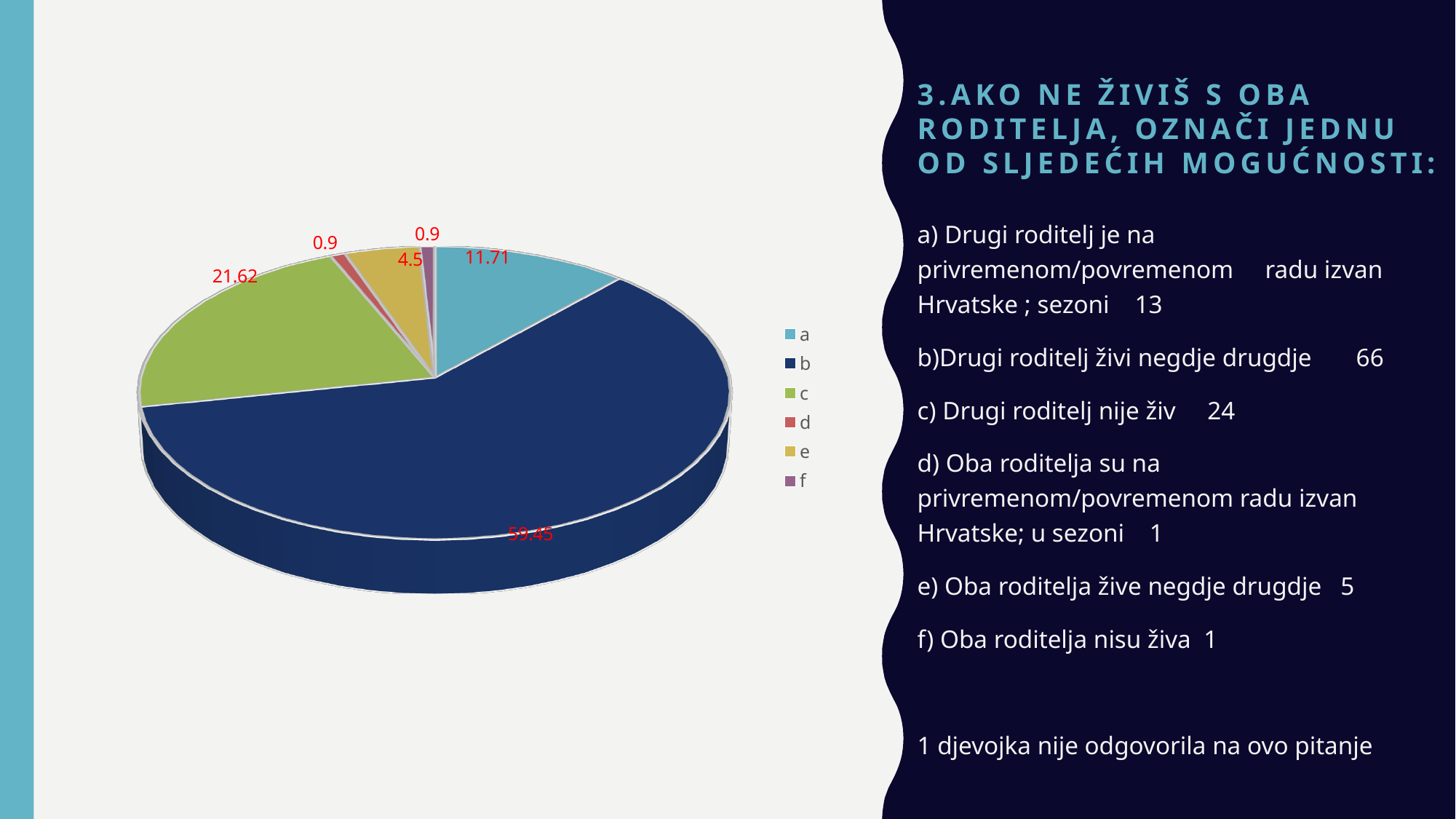
What is the value shown for slice b in the pie chart? 59.45 Which slice of the pie chart is the largest? b What is the difference between the values for slice b and slice c in the pie chart? 37.83 What is the value shown for slice c in the pie chart? 21.62 What colour is slice b in the pie chart? dark blue Which is larger in the pie chart, slice c or slice a? c How many slices does the pie chart have? 6 What is the value shown for slice d in the pie chart? 0.9 What is the difference between the values for slice a and slice e in the pie chart? 7.21 What is the value shown for slice e in the pie chart? 4.5 What is the value shown for slice a in the pie chart? 11.71 What kind of chart is shown on the slide? pie chart